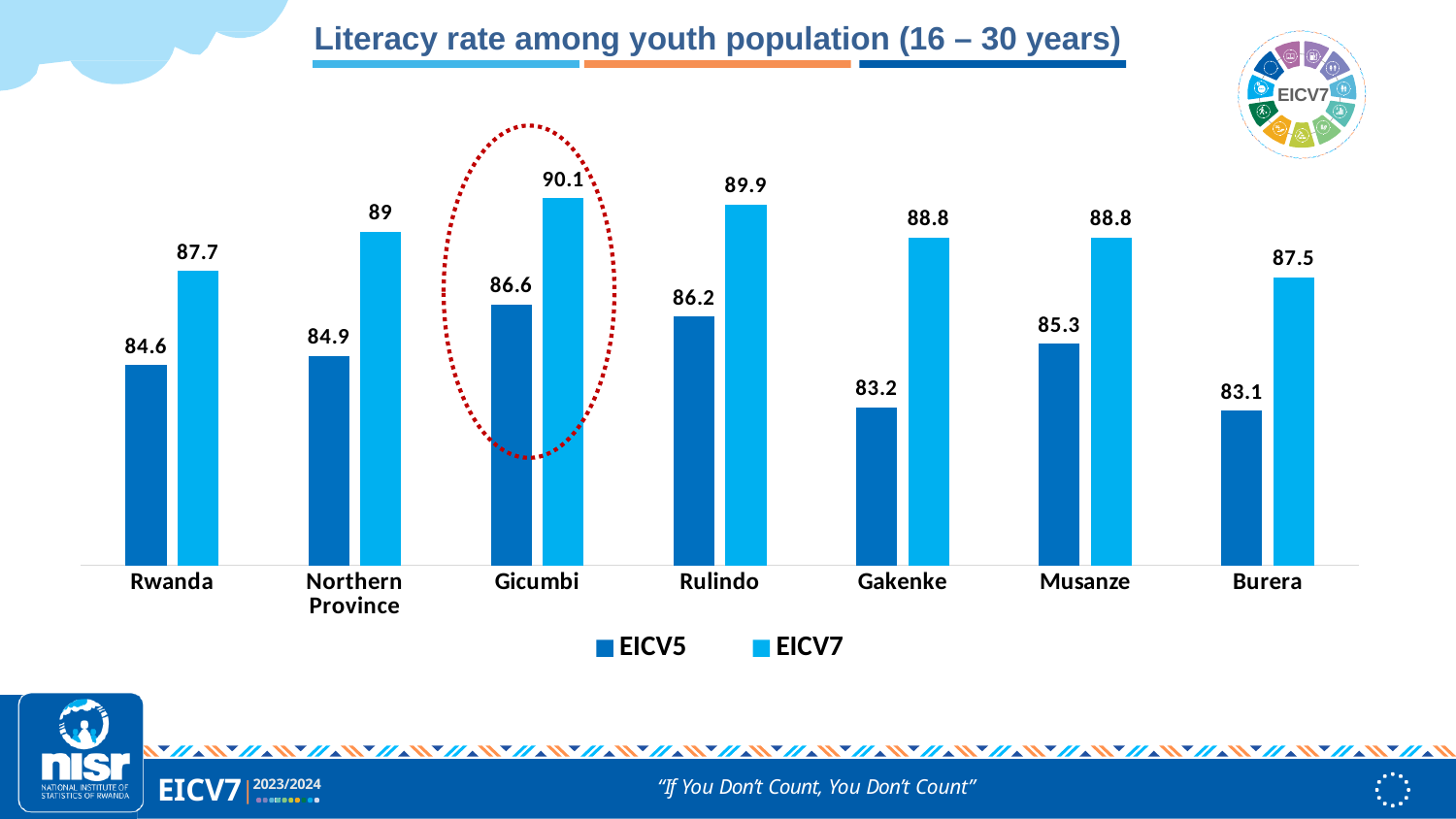
Which category has the lowest EICV5 value? Burera What is the EICV7 value for Northern Province? 89 Which is larger, the EICV5 value for Musanze or the EICV5 value for Rulindo? Rulindo What is the difference between the EICV7 values for Gicumbi and Rwanda? 2.4 What is the EICV5 literacy rate for Gakenke? 83.2 How many series does the legend list? 2 How many categories are shown on the x axis? 7 What is the EICV7 literacy rate for Gicumbi? 90.1 What kind of chart is shown on the slide? Bar chart Which category has the highest EICV7 value? Gicumbi What is the difference between the EICV7 and EICV5 values for Gakenke? 5.6 Which category is highlighted with a dotted red circle? Gicumbi